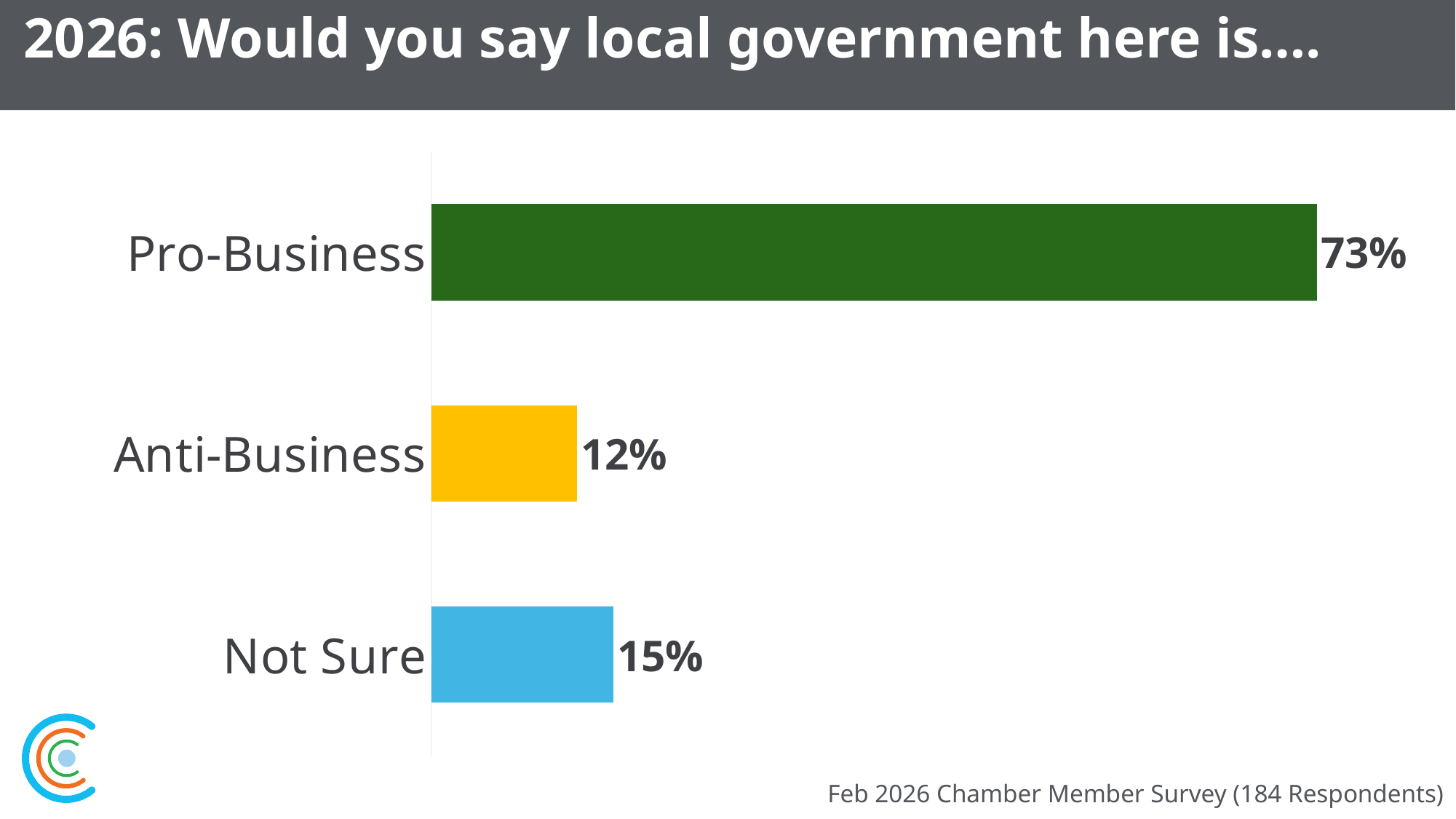
Which response category has the highest percentage? Pro-Business What percentage of respondents said local government is Anti-Business? 12% What percentage of respondents answered Not Sure? 15% What is the difference in percentage points between Not Sure and Anti-Business? 3 What kind of chart is shown on the slide? Bar chart What is the title of the chart? 2026: Would you say local government here is.... Which is larger, the value for Not Sure or the value for Anti-Business? Not Sure What is the difference in percentage points between Pro-Business and Anti-Business? 61 What percentage of respondents said local government is Pro-Business? 73% How many response categories are shown in the chart? 3 Which response category has the lowest percentage? Anti-Business How many respondents took part in the survey, according to the source note? 184